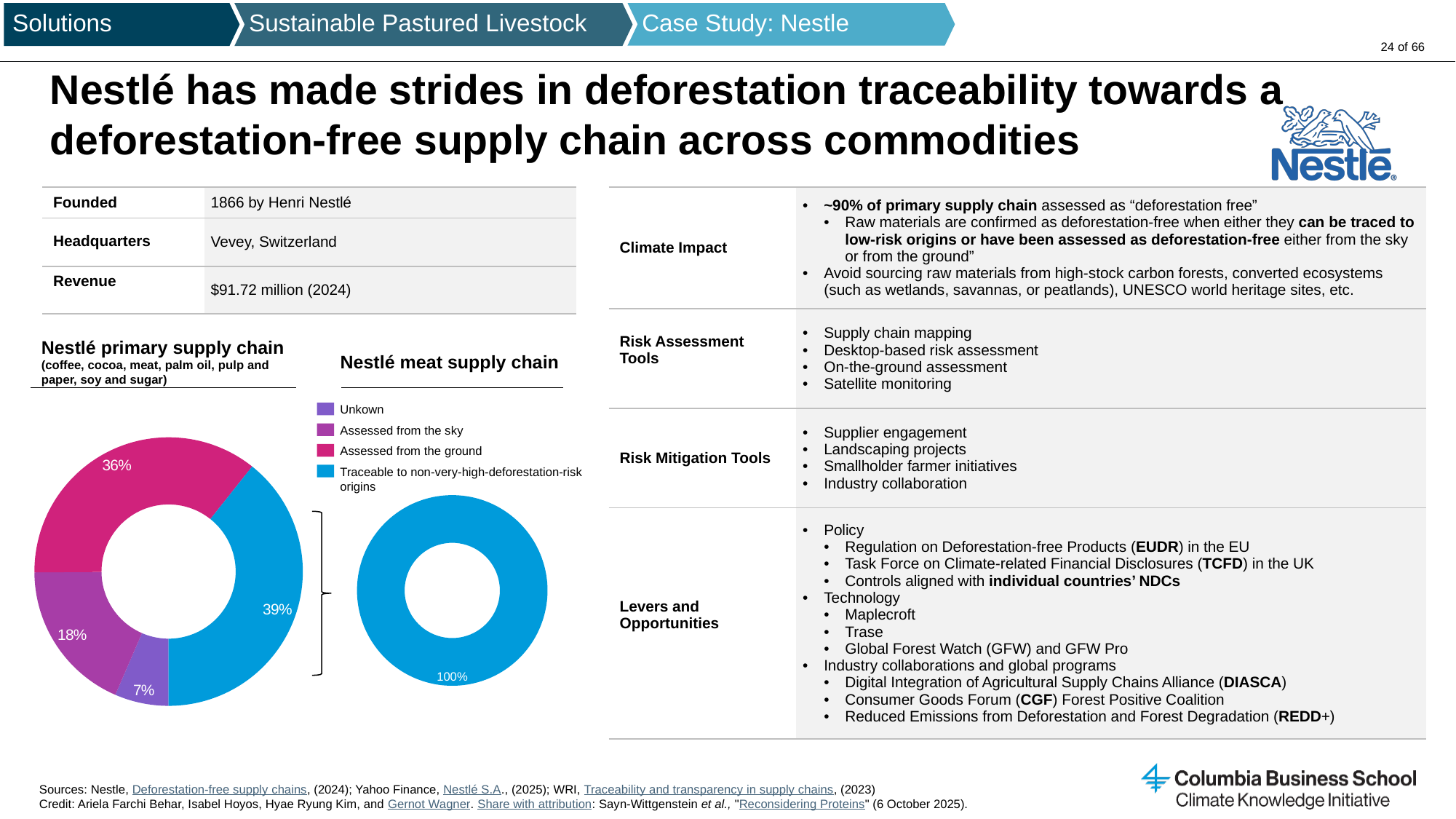
In the Nestlé primary supply chain chart, which is larger: the share assessed from the ground or the share traceable to non-very-high-deforestation-risk origins? Traceable to non-very-high-deforestation-risk origins In the Nestlé primary supply chain chart, what share is assessed from the ground? 36% What share is shown in the Nestlé meat supply chain chart? 100% In the Nestlé primary supply chain chart, which category has the smallest share? Unknown In the Nestlé primary supply chain chart, which category has the largest share? Traceable to non-very-high-deforestation-risk origins How many slices does the Nestlé primary supply chain chart have? 4 In the Nestlé primary supply chain chart, what share is unknown? 7% In the Nestlé primary supply chain chart, what share is assessed from the sky? 18% How many entries does the legend shared by the two supply chain charts list? 4 In the Nestlé primary supply chain chart, what is the difference in percentage points between the share assessed from the ground and the share assessed from the sky? 18 In the Nestlé primary supply chain chart, what share is traceable to non-very-high-deforestation-risk origins? 39% What type of chart is used for the Nestlé meat supply chain? Donut (pie) chart